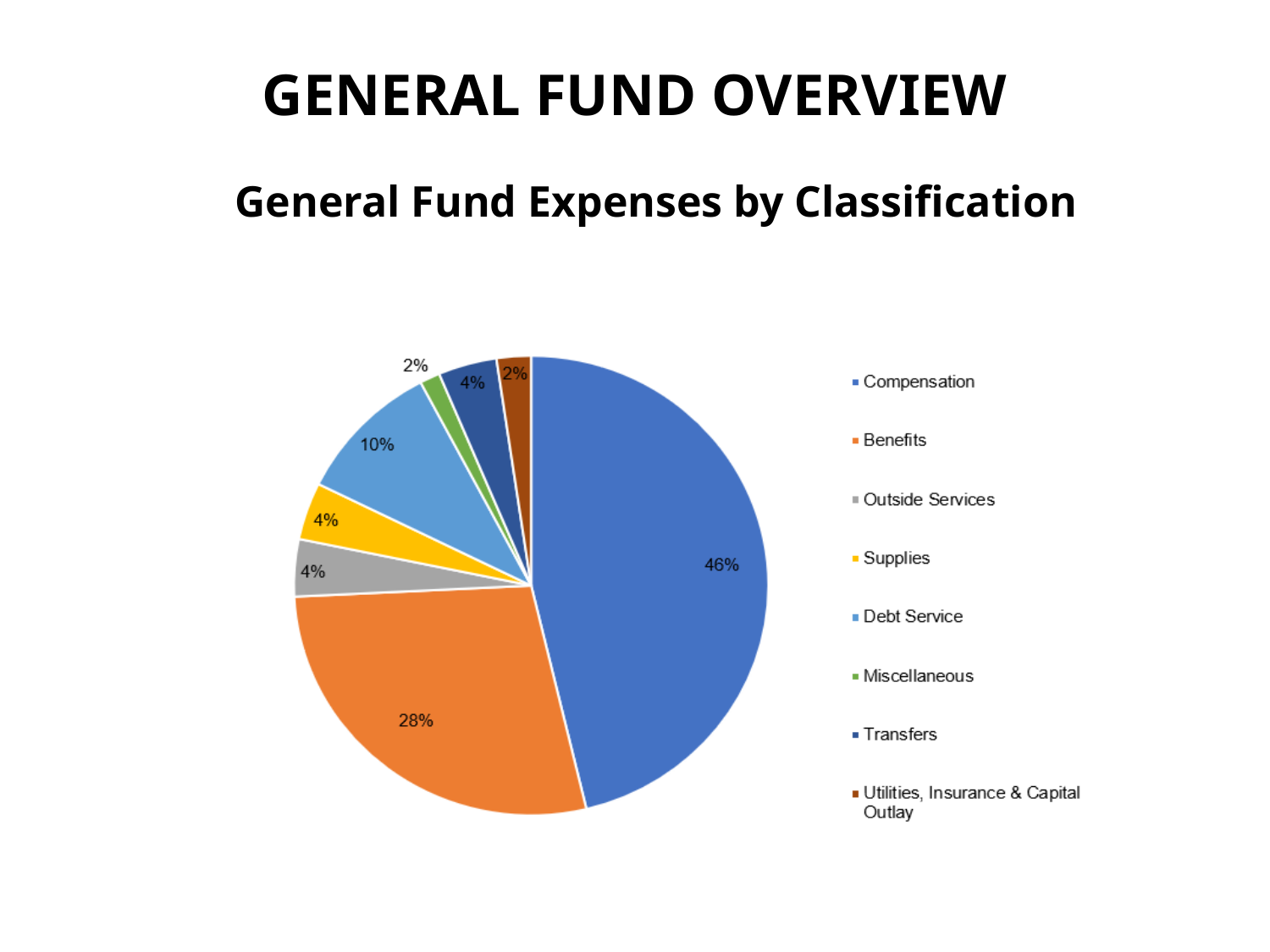
Which legend entry is shown in orange? Benefits What is the title of the chart? General Fund Expenses by Classification What share of General Fund expenses is Supplies? 4% What share of General Fund expenses is Benefits? 28% Which is larger, the share for Benefits or the share for Debt Service? Benefits What share of General Fund expenses is Compensation? 46% What share of General Fund expenses is Debt Service? 10% What is the difference in percentage points between the Compensation share and the Benefits share? 18 How many classifications does the legend list? 8 What share of General Fund expenses is Miscellaneous? 2% What kind of chart is shown on the slide? Pie chart Which classification has the largest share of General Fund expenses? Compensation